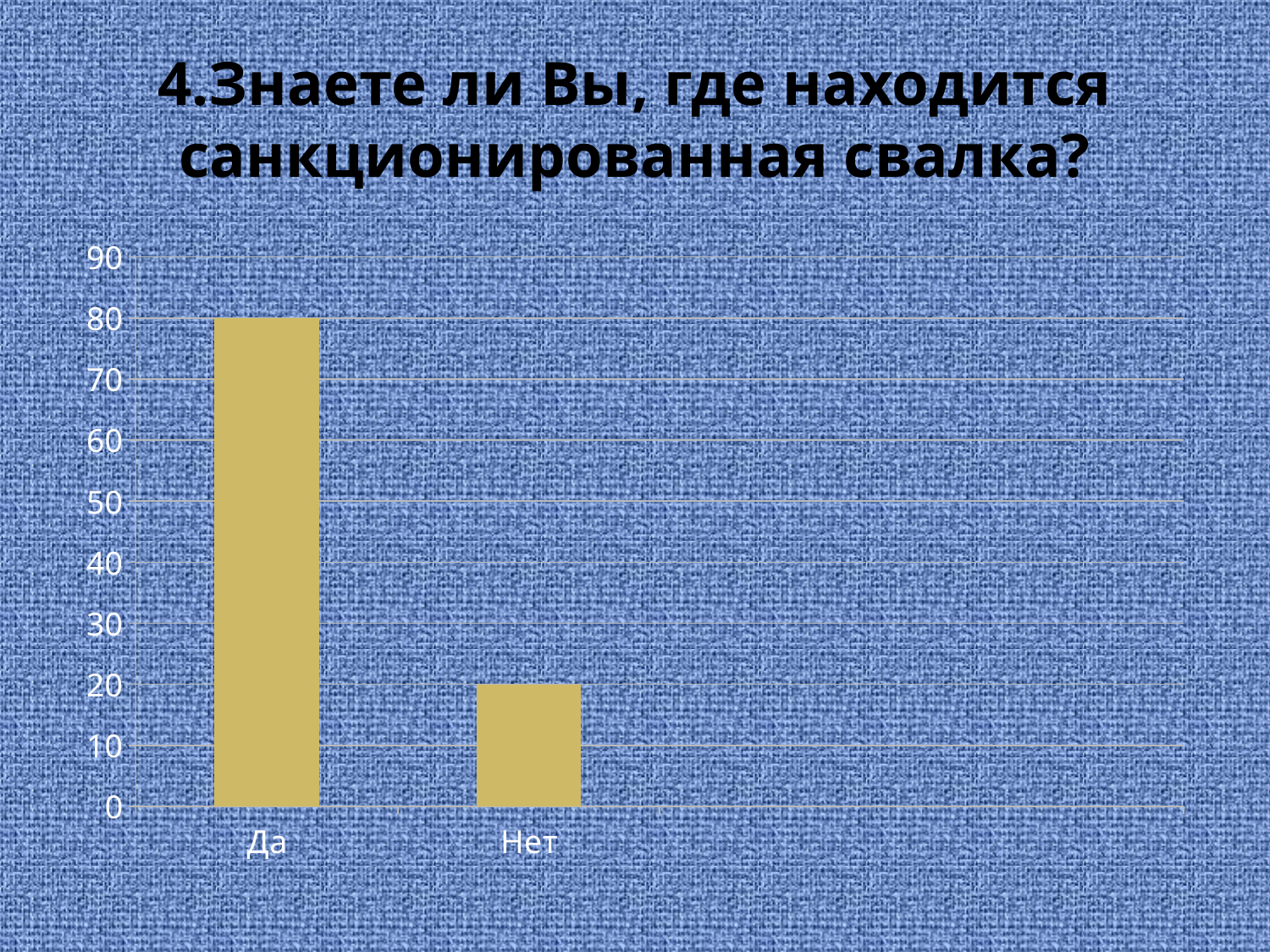
Is the value for "Нет" greater or less than 30? less What is the title of the slide above the chart? 4.Знаете ли Вы, где находится санкционированная свалка? What is the highest value shown on the vertical axis? 90 What is the value for "Да"? 80 What is the difference between the values for "Да" and "Нет"? 60 Which category has the highest value? Да What kind of chart is shown on the slide? bar chart What is the value for "Нет"? 20 How many categories are shown on the x axis? 2 Is the value for "Да" greater or less than 50? greater Which is larger, the value for "Да" or the value for "Нет"? Да Which category has the lowest value? Нет